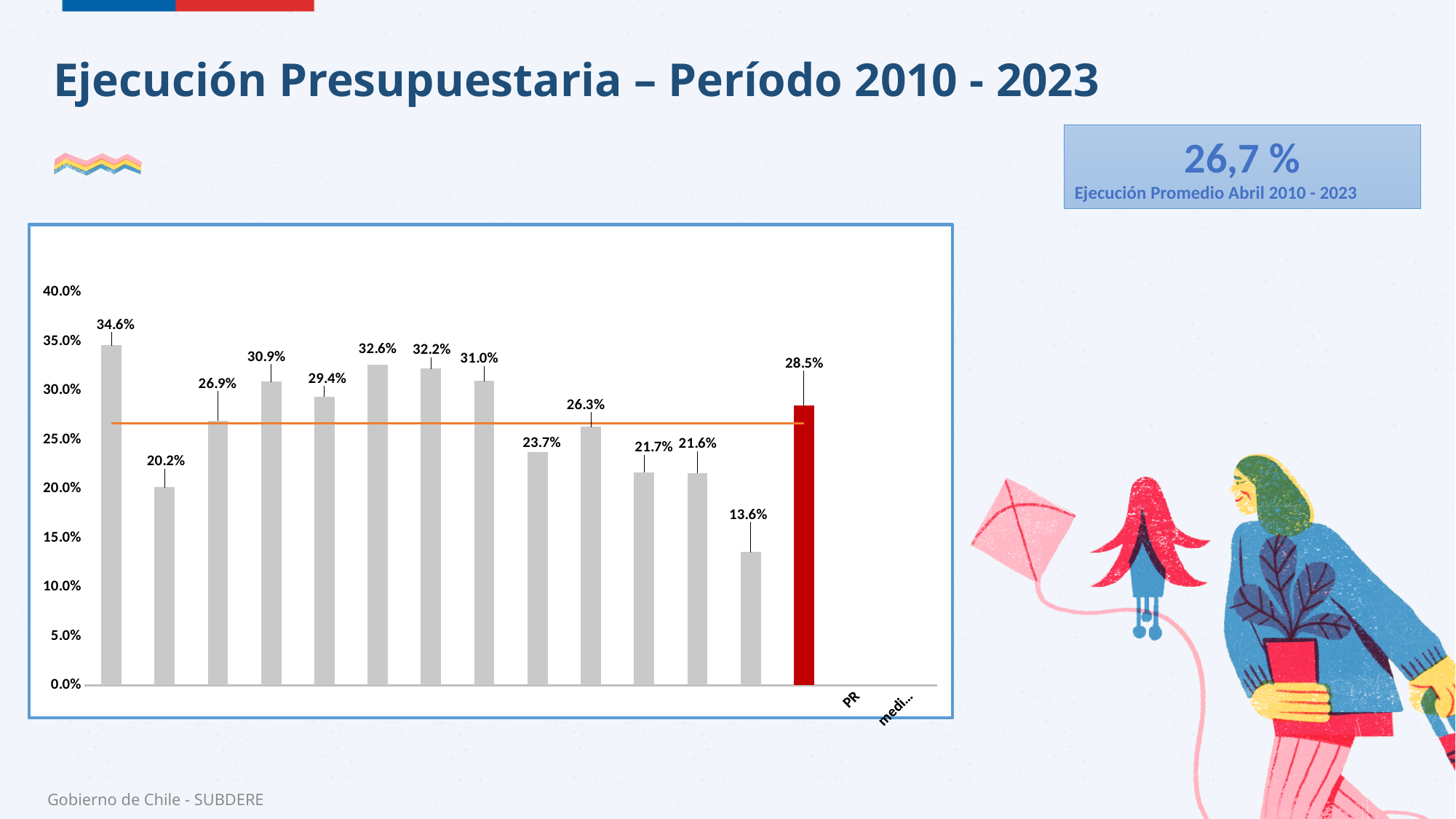
Is the value of the red bar greater or less than 25%? greater What is the lowest value shown in the chart? 13.6% What is the difference between the highest bar (34.6%) and the lowest bar (13.6%)? 21.0 percentage points What is the value of the red bar in the chart? 28.5% What is the value of the first bar on the left of the chart? 34.6% Which is larger: the red bar or the first bar on the left? the first bar on the left (34.6%) What colour is the highlighted bar that differs from the grey bars? red What is the value of the second bar from the left in the chart? 20.2% How many bars are plotted in the chart? 14 What is the highest value shown in the chart? 34.6% What average value is shown in the box at the top right of the slide? 26,7 % What type of chart is shown on the slide? bar chart